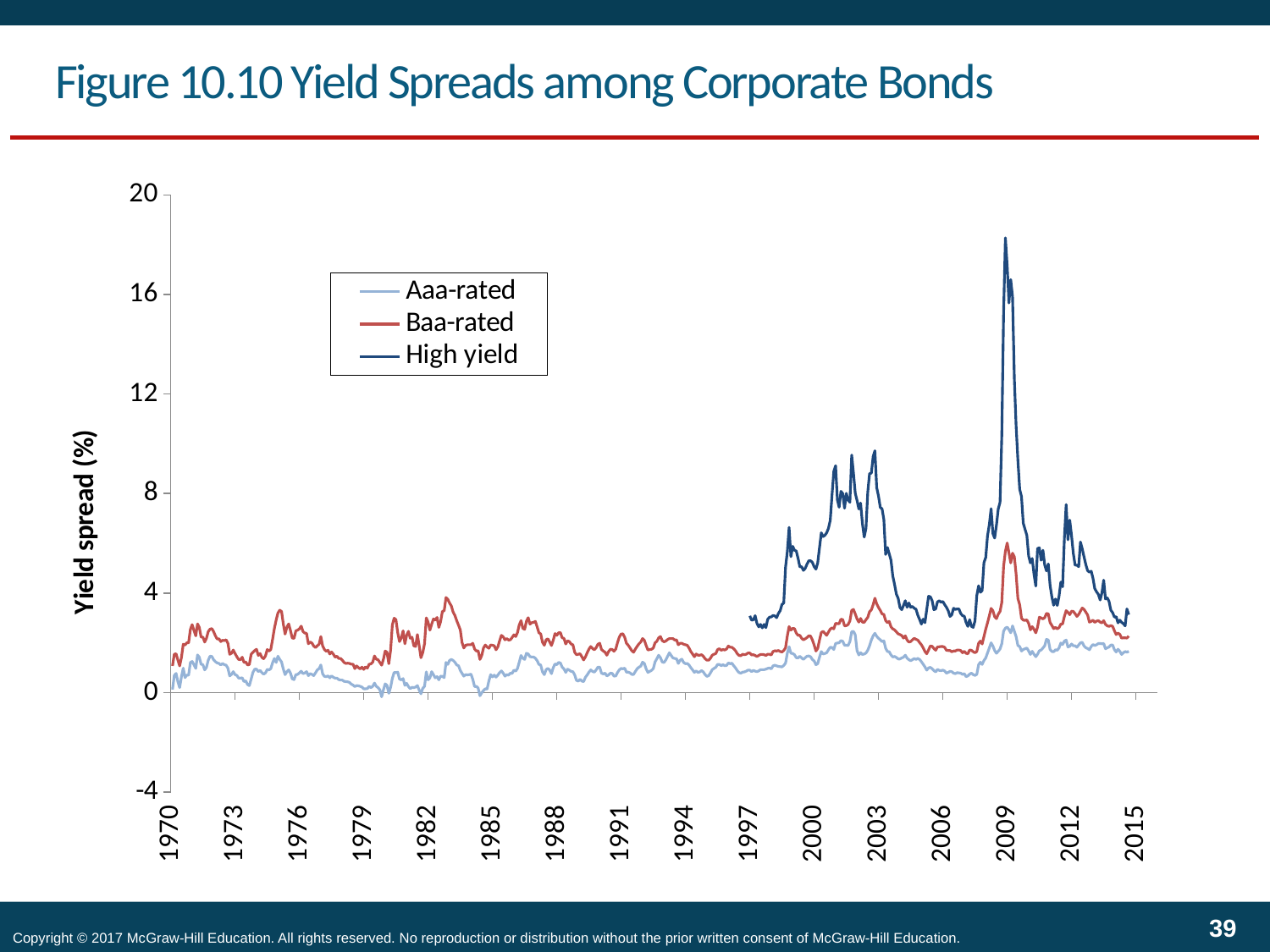
What kind of chart is shown on the slide? Line chart Which series reaches the highest yield spread on the chart? High yield How many year labels are shown on the horizontal axis? 16 How many series does the legend list? 3 Is the peak value of the Baa-rated series around 2009 greater or less than 4? greater Does the High yield series rise or fall from its 2009 peak to 2015? Fall What is the label of the vertical axis? Yield spread (%) Which series has the lowest yield spread across the chart? Aaa-rated What are the three series listed in the legend? Aaa-rated, Baa-rated, High yield Around 2009, which is larger: the High yield spread or the Baa-rated spread? High yield Is the peak value of the High yield series around 2009 greater or less than 16? greater Is the Aaa-rated series ever greater or less than 4 over the whole period? less